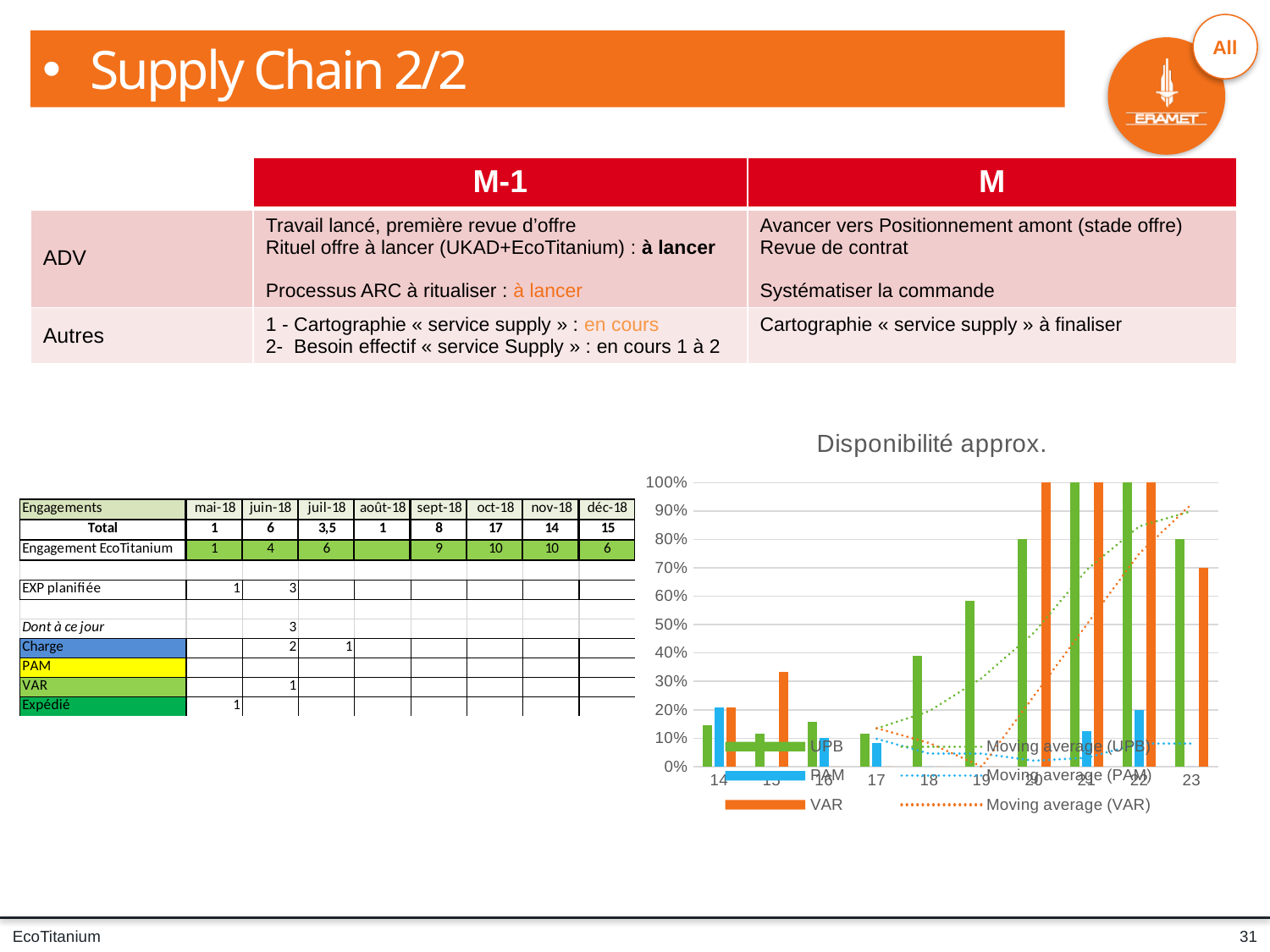
In the "Disponibilité approx." chart, do the UPB bars generally rise or fall from category 17 to category 21? rise How many categories are shown along the x axis of the "Disponibilité approx." chart? 10 In the "Disponibilité approx." chart, is the UPB value at category 19 greater or less than 50%? greater In the "Disponibilité approx." chart, what value does the UPB bar reach at category 21? 100% What kind of chart is shown under the title "Disponibilité approx."? bar chart How many entries does the legend of the "Disponibilité approx." chart list? 6 In the "Disponibilité approx." chart, what value does the VAR bar reach at category 20? 100% In the "Disponibilité approx." chart, which is larger at category 23: the UPB bar or the VAR bar? UPB In the "Disponibilité approx." chart, is the PAM value at category 21 greater or less than 20%? less In the "Disponibilité approx." chart, which is larger at category 15: the UPB bar or the VAR bar? VAR In the "Disponibilité approx." chart, is the VAR value at category 15 greater or less than 20%? greater What is the title of the chart on the slide? Disponibilité approx.